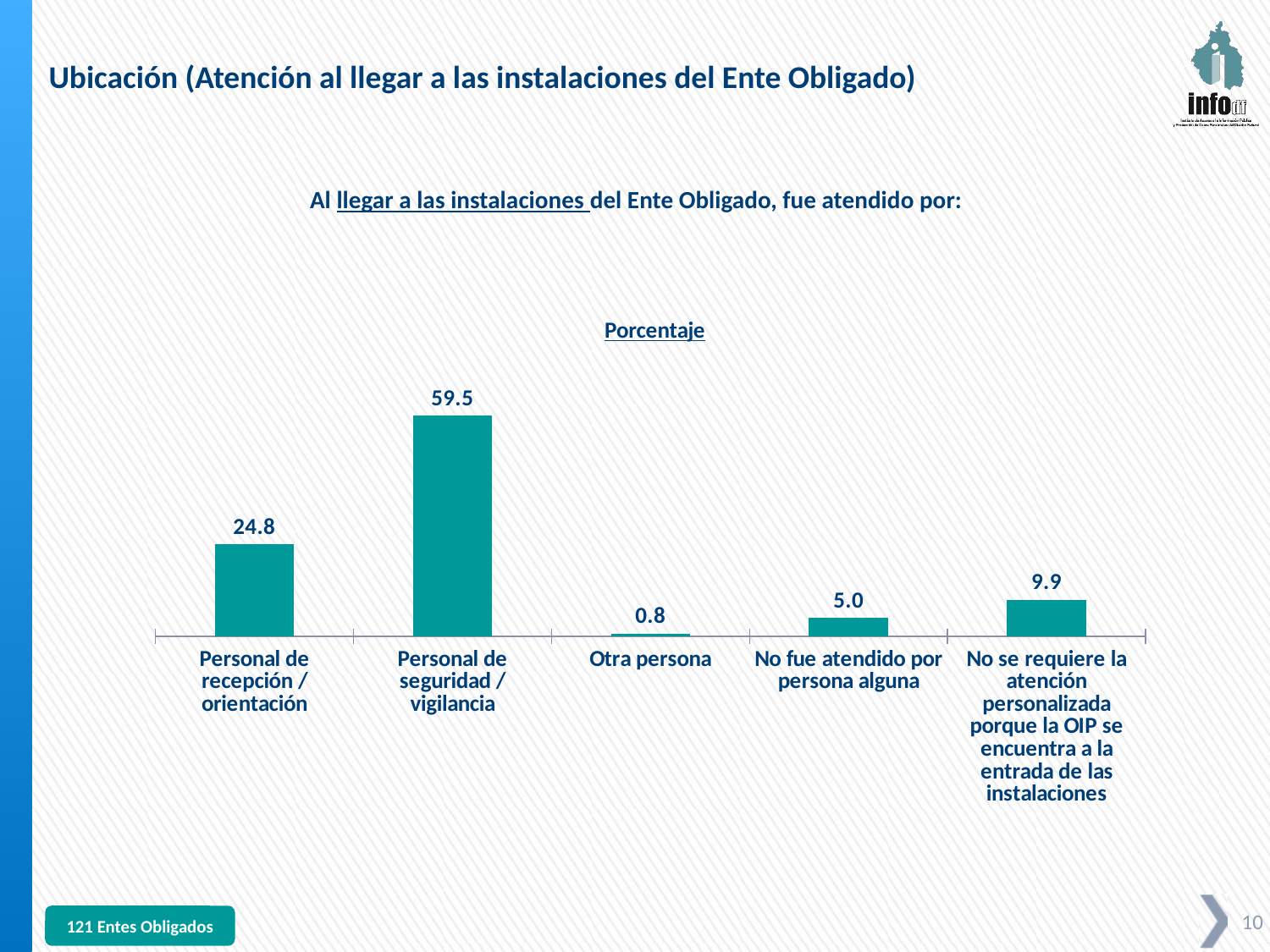
Which category has the lowest value? Otra persona What is the difference between the values for "Personal de seguridad / vigilancia" and "Personal de recepción / orientación"? 34.7 What is the value for "No fue atendido por persona alguna"? 5.0 What is the value for "Personal de recepción / orientación"? 24.8 Which category has the highest value? Personal de seguridad / vigilancia What is the value for "Otra persona"? 0.8 What is the title shown above the chart? Porcentaje What kind of chart is shown on the slide? Bar chart How many categories are shown in the chart? 5 What is the difference between the values for "No se requiere la atención personalizada porque la OIP se encuentra a la entrada de las instalaciones" and "No fue atendido por persona alguna"? 4.9 Which is larger: the value for "No fue atendido por persona alguna" or the value for "No se requiere la atención personalizada porque la OIP se encuentra a la entrada de las instalaciones"? No se requiere la atención personalizada porque la OIP se encuentra a la entrada de las instalaciones What is the value for "Personal de seguridad / vigilancia"? 59.5